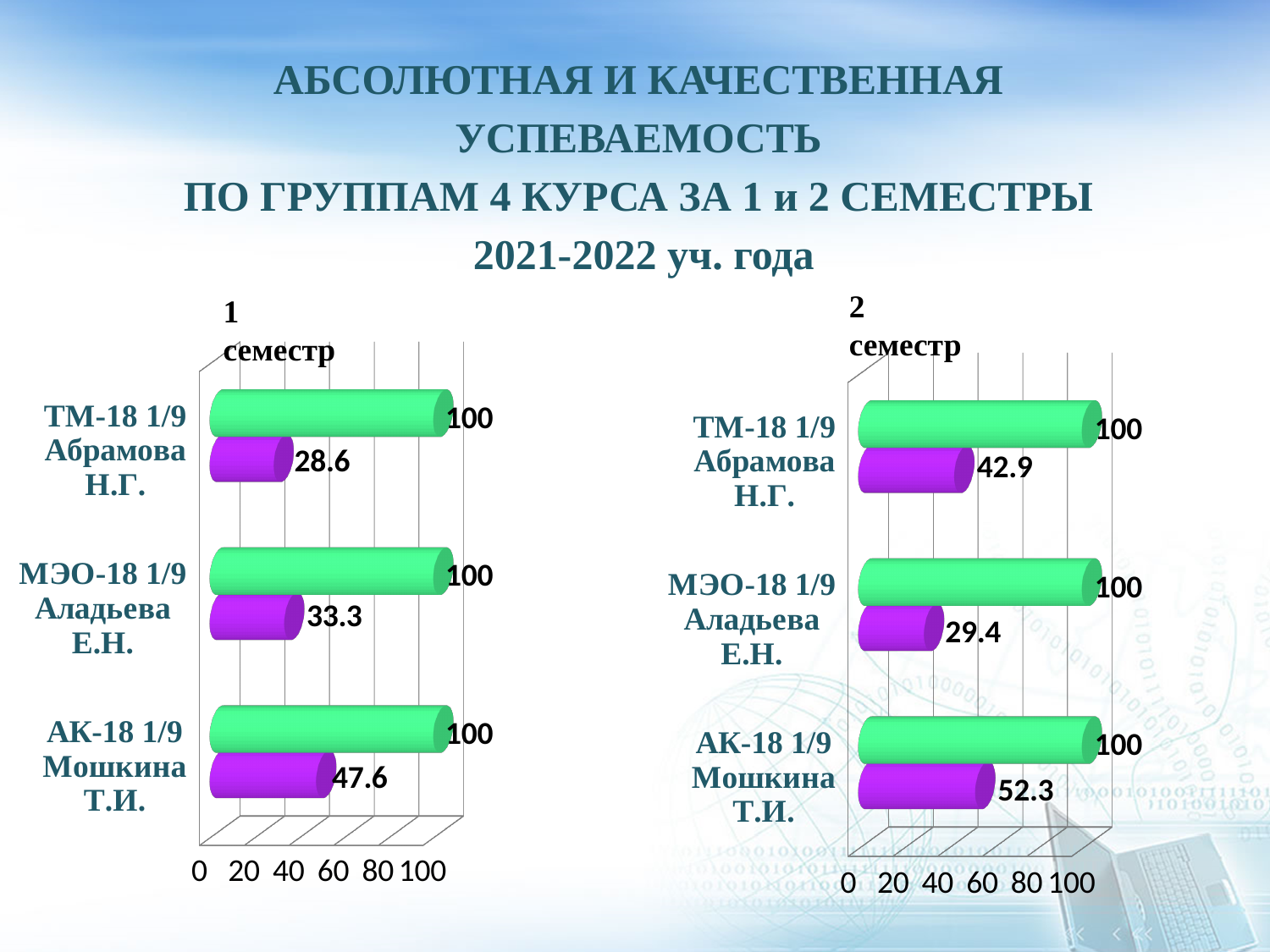
In the "2 семестр" chart, what is the value of the purple bar for МЭО-18 1/9 Аладьева Е.Н.? 29.4 How many groups are shown in the "1 семестр" chart? 3 Which is larger: the purple bar for ТМ-18 1/9 Абрамова Н.Г. in the "1 семестр" chart or in the "2 семестр" chart? 2 семестр In the "1 семестр" chart, what is the value of the purple bar for АК-18 1/9 Мошкина Т.И.? 47.6 In the "1 семестр" chart, what is the value of the green bar for МЭО-18 1/9 Аладьева Е.Н.? 100 What type of chart is the "2 семестр" chart? Bar chart In the "2 семестр" chart, what is the difference between the purple bar values for АК-18 1/9 Мошкина Т.И. and МЭО-18 1/9 Аладьева Е.Н.? 22.9 In the "1 семестр" chart, what is the difference between the purple bar values for АК-18 1/9 Мошкина Т.И. and ТМ-18 1/9 Абрамова Н.Г.? 19 In the "2 семестр" chart, what is the value of the purple bar for ТМ-18 1/9 Абрамова Н.Г.? 42.9 In the "2 семестр" chart, which group has the lowest purple bar value? МЭО-18 1/9 Аладьева Е.Н. In the "1 семестр" chart, which group has the highest purple bar value? АК-18 1/9 Мошкина Т.И. How many bars are shown for each group in the "1 семестр" chart? 2